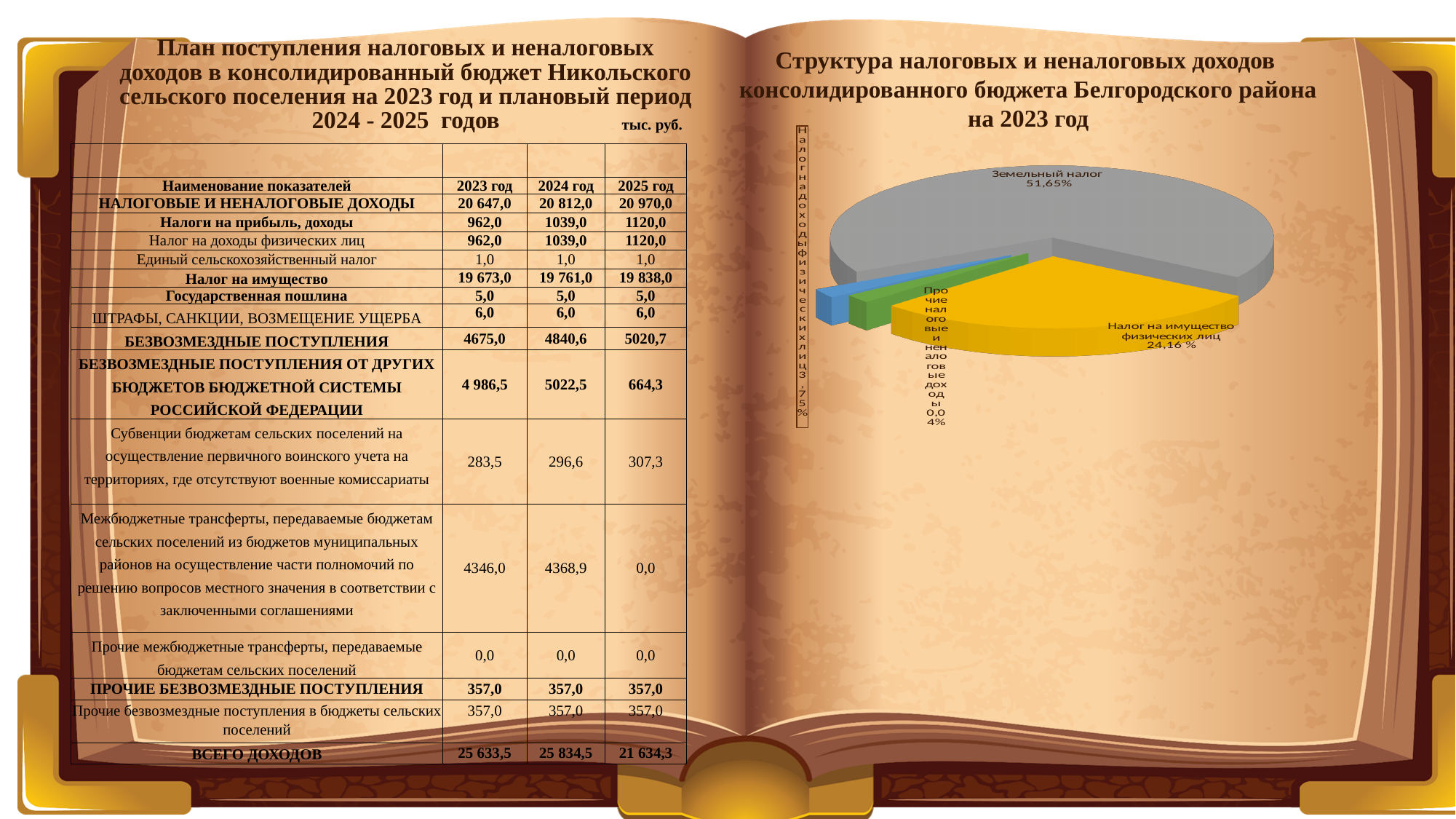
Which labelled slice of the pie chart has the smallest share? Прочие налоговые и неналоговые доходы Which slice of the pie chart is the largest? Земельный налог In the pie chart, what share is shown for Прочие налоговые и неналоговые доходы? 0,04% How many slices does the pie chart have? 4 In the pie chart, which is larger: Земельный налог or Налог на имущество физических лиц? Земельный налог In the pie chart, by how many percentage points does the share of Земельный налог exceed that of Налог на имущество физических лиц? 27,49 What kind of chart is shown on the right side of the slide? pie chart In the pie chart, what share is shown for Земельный налог? 51,65% What colour is the Земельный налог slice in the pie chart? grey In the pie chart, what share is shown for Налог на имущество физических лиц? 24,16 % What is the title of the pie chart? Структура налоговых и неналоговых доходов консолидированного бюджета Белгородского района на 2023 год